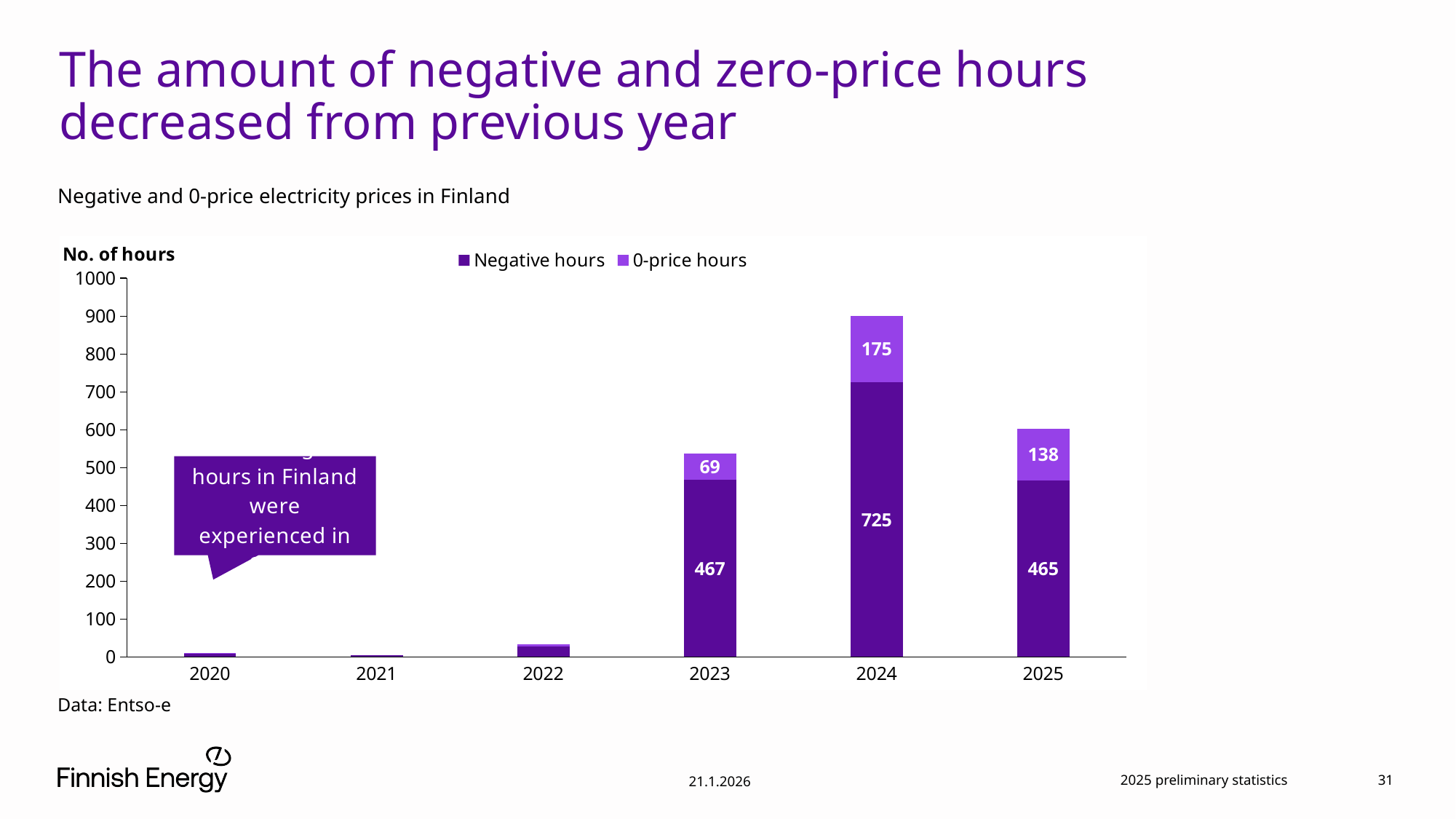
How many negative hours were there in 2024? 725 What is the total number of negative and 0-price hours in 2024? 900 How many 0-price hours were there in 2025? 138 What kind of chart is shown on the slide? Stacked bar chart How many series does the legend list? 2 How many years are shown on the x axis? 6 Which year had more 0-price hours, 2023 or 2024? 2024 How many negative hours were there in 2023? 467 What is the difference in negative hours between 2024 and 2025? 260 Is the total number of hours for 2022 greater or less than 100? less Which year had the highest number of negative hours? 2024 What is the total number of negative and 0-price hours in 2025? 603